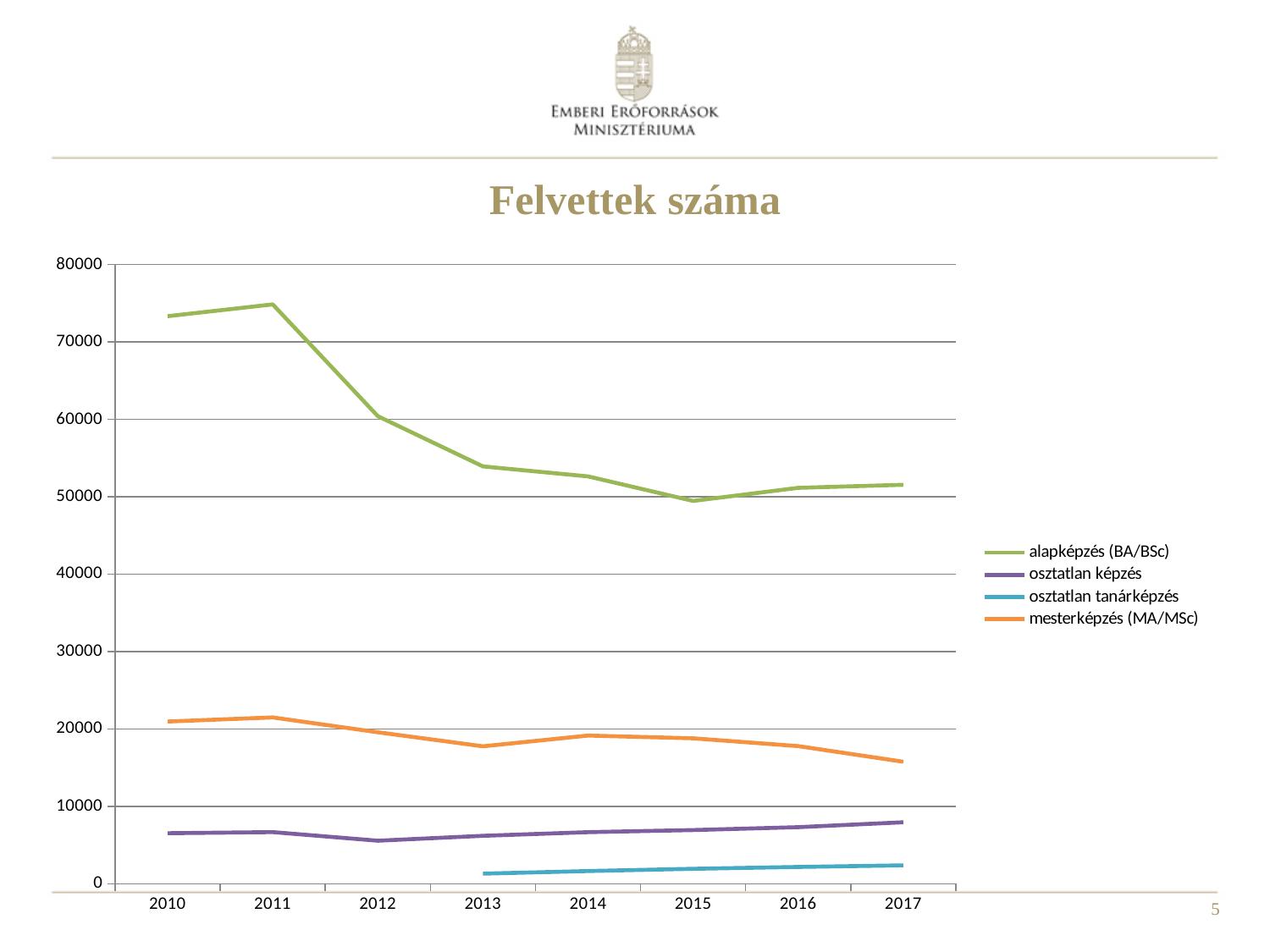
How many years are shown on the x axis? 8 In which year is the alapképzés (BA/BSc) series at its highest? 2011 In 2017, which is larger: osztatlan képzés or osztatlan tanárképzés? osztatlan képzés Is the value for alapképzés (BA/BSc) in 2010 greater or less than 70000? greater How many series does the legend list? 4 In which year does the osztatlan tanárképzés series first appear? 2013 What is the title of the chart? Felvettek száma In which year is the alapképzés (BA/BSc) series at its lowest? 2015 Which series has the highest values across all years? alapképzés (BA/BSc) Does the alapképzés (BA/BSc) series rise or fall overall from 2010 to 2017? fall Is the value for mesterképzés (MA/MSc) in 2017 greater or less than 20000? less What kind of chart is shown on the slide? line chart